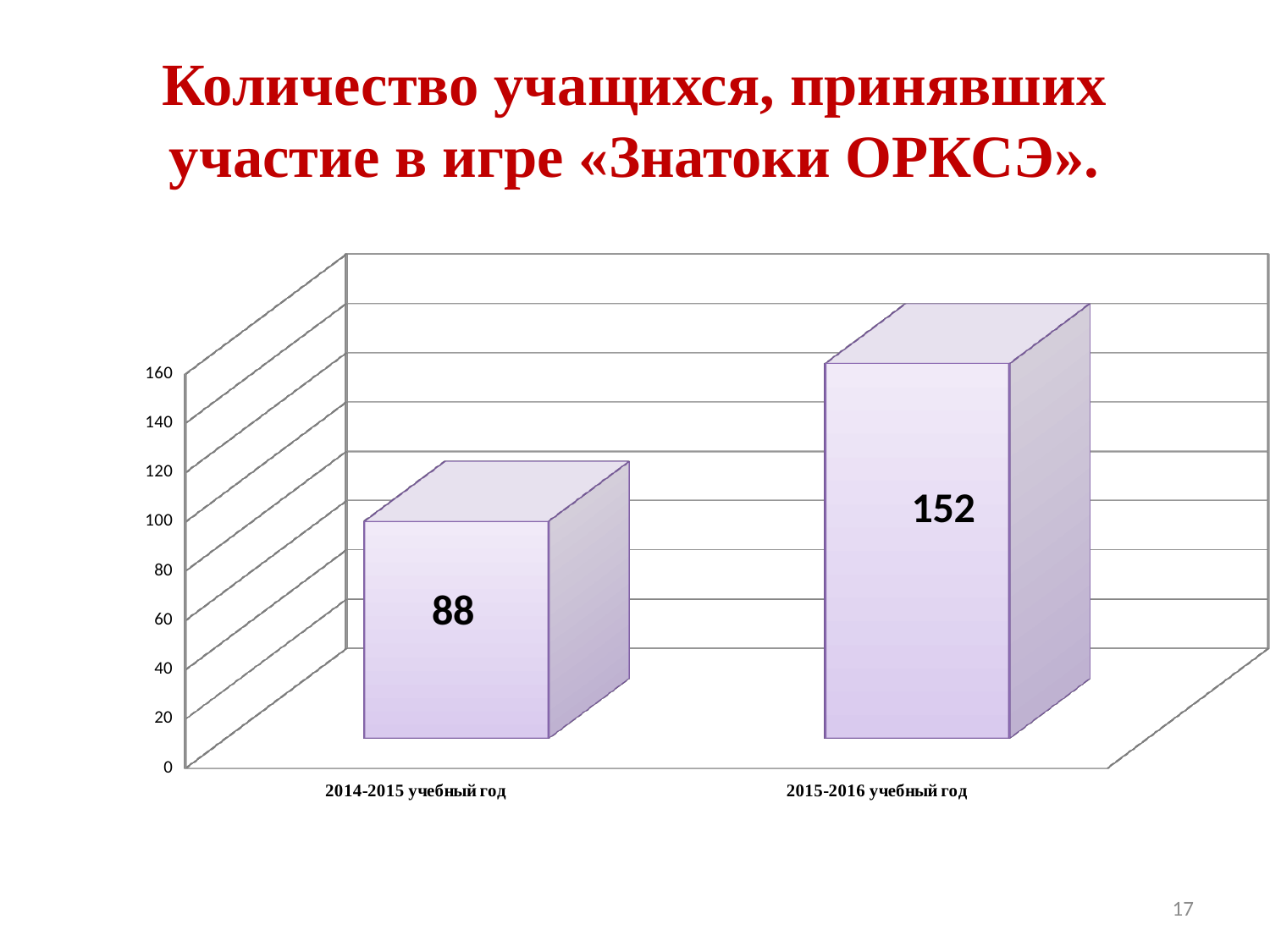
What is the value for 2014-2015 учебный год? 88 Which category has the lowest value? 2014-2015 учебный год Which is larger: the value for 2014-2015 учебный год or for 2015-2016 учебный год? 2015-2016 учебный год What is the difference between the values for 2015-2016 учебный год and 2014-2015 учебный год? 64 What is the title of the slide? Количество учащихся, принявших участие в игре «Знатоки ОРКСЭ». What kind of chart is shown on the slide? bar chart Is the value for 2014-2015 учебный год greater or less than 100? less Is the value for 2015-2016 учебный год greater or less than 140? greater What is the value for 2015-2016 учебный год? 152 Which category has the highest value? 2015-2016 учебный год How many categories are shown on the chart? 2 Do the values rise or fall from 2014-2015 учебный год to 2015-2016 учебный год? rise